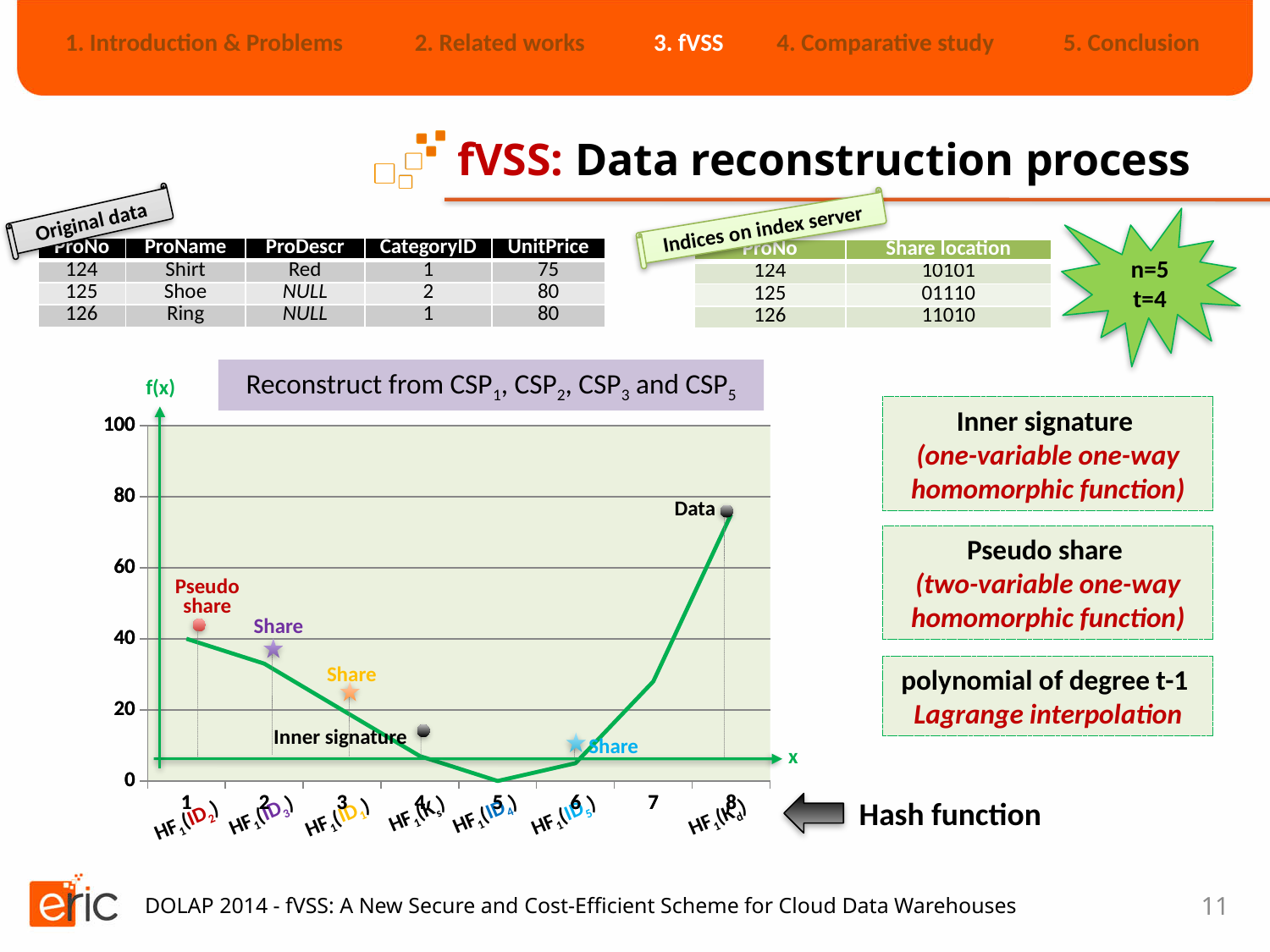
Which has the larger f(x) value, the point labelled 'Pseudo share' or the point labelled 'Inner signature'? Pseudo share Does the curve rise or fall as x goes from 1 to 5? fall What is the title shown above the chart? Reconstruct from CSP1, CSP2, CSP3 and CSP5 Which has the larger f(x) value, the point labelled 'Data' or the point labelled 'Pseudo share'? Data Is the f(x) value of the point labelled 'Inner signature' greater or less than 20? less Is the f(x) value of the point labelled 'Data' greater or less than 60? greater What is the label on the vertical axis of the chart? f(x) Is the f(x) value of the 'Share' point at x = 3 greater or less than 40? less Which labelled point on the chart has the highest f(x) value? Data What kind of chart is shown on the slide? line chart How many numbered positions are marked along the x axis of the chart? 8